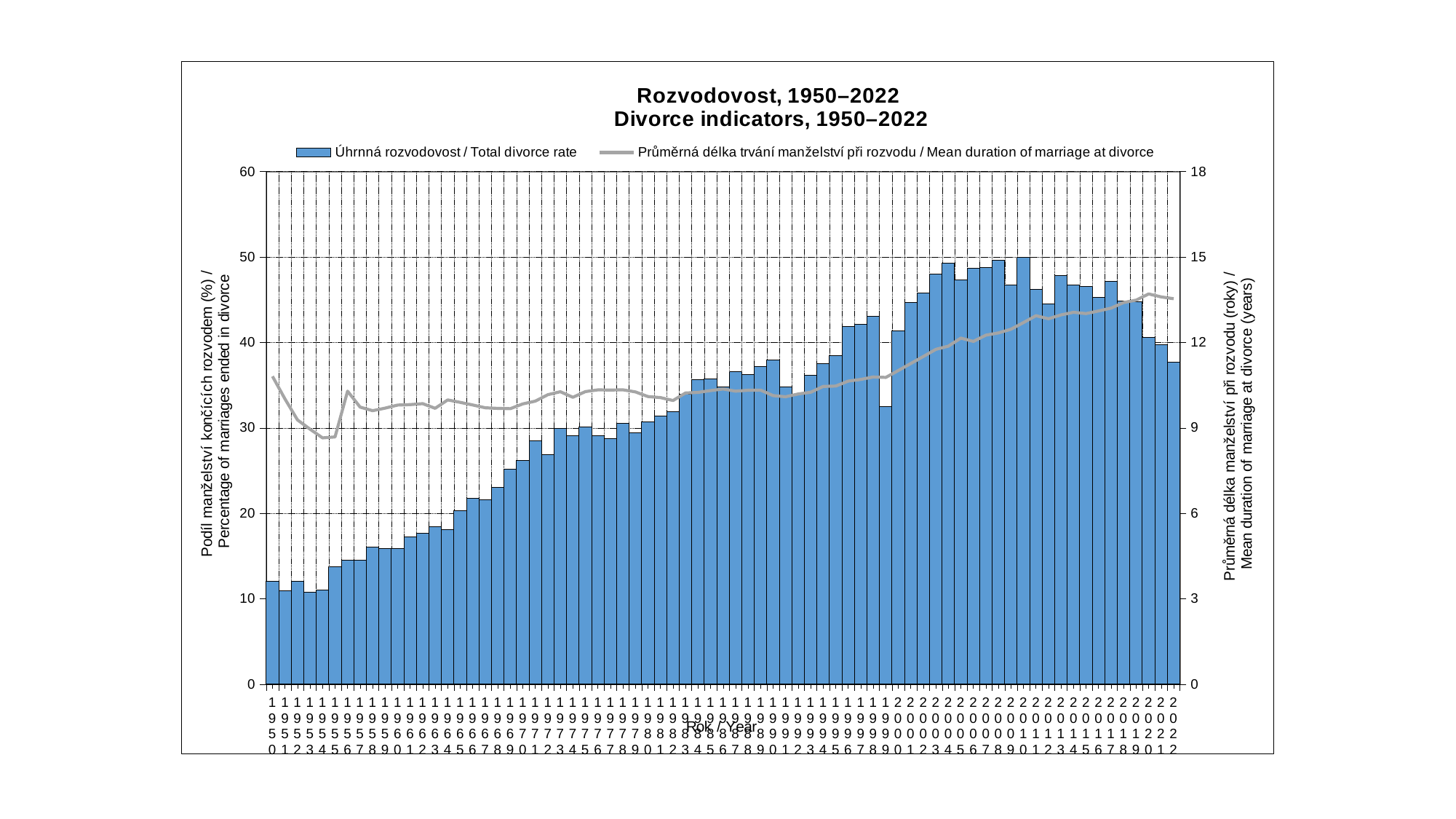
Is the total divorce rate for 1950 greater or less than 20? less Does the total divorce rate generally rise or fall from 1950 to 2010? Rise Is the mean duration of marriage at divorce in 2022 greater or less than 12 years? greater What is the English title of the chart? Divorce indicators, 1950–2022 What colour is the line showing mean duration of marriage at divorce? Grey Which year has the larger total divorce rate, 1950 or 2010? 2010 Is the total divorce rate for 2010 greater or less than 40? greater Which year has the larger total divorce rate, 1998 or 1999? 1998 What kind of chart is shown on the slide? Bar chart with a line overlay How many series does the legend list? 2 How many years are plotted along the x axis? 73